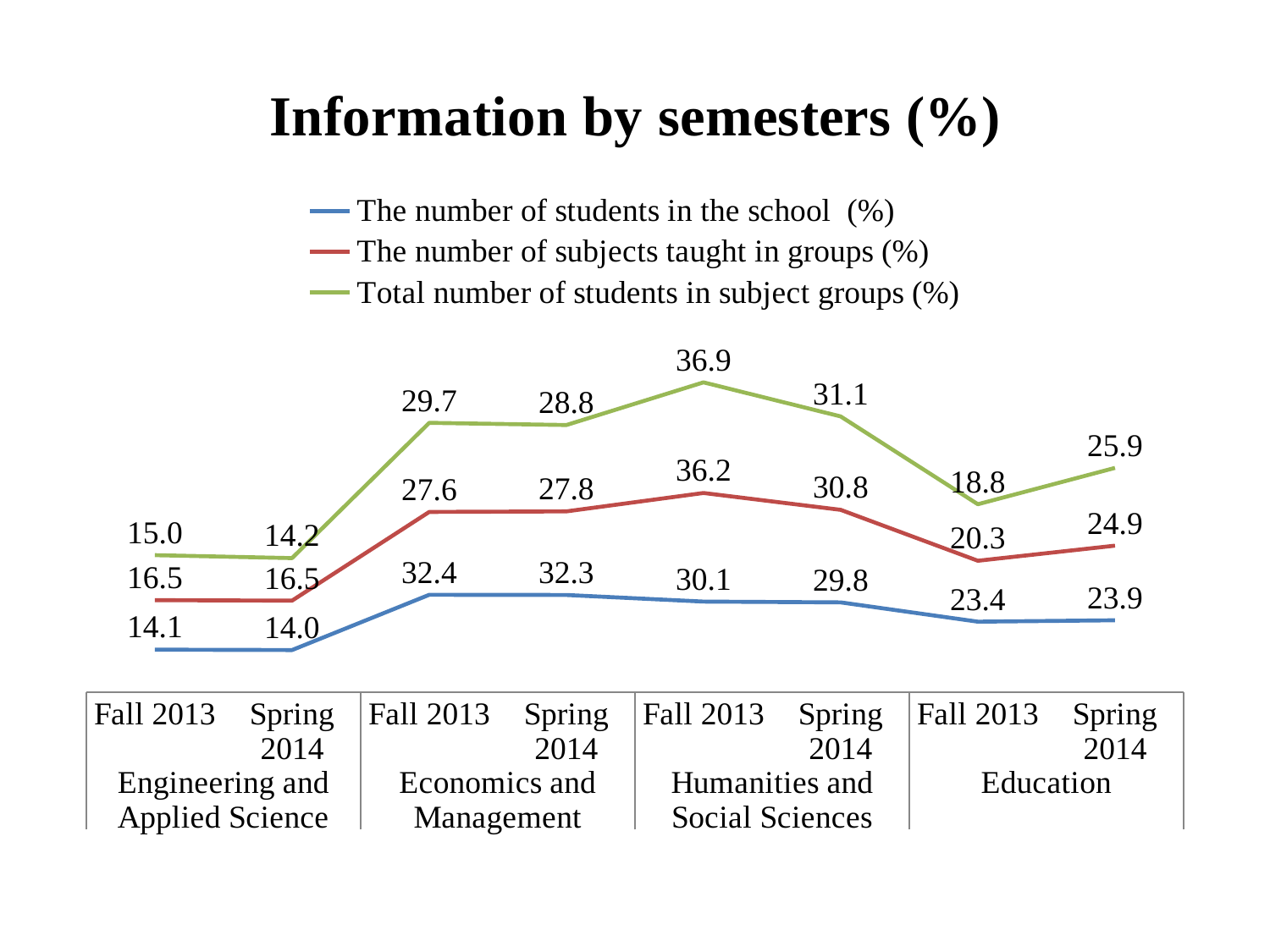
How many series does the legend list? 3 What is the value of 'The number of subjects taught in groups (%)' for Education in Spring 2014? 24.9 What is the value of 'Total number of students in subject groups (%)' for Humanities and Social Sciences in Fall 2013? 36.9 What is the title of the chart? Information by semesters (%) What type of chart is shown on the slide? Line chart What is the difference between the 'Total number of students in subject groups (%)' values for Humanities and Social Sciences in Fall 2013 and Spring 2014? 5.8 At which semester and school is 'The number of students in the school (%)' lowest? Engineering and Applied Science, Spring 2014 How many data points are plotted along the x axis for each series? 8 At which semester and school does 'Total number of students in subject groups (%)' reach its highest value? Humanities and Social Sciences, Fall 2013 For Education in Fall 2013, which is larger: 'The number of students in the school (%)' or 'Total number of students in subject groups (%)'? The number of students in the school (%) What is the value of 'The number of students in the school (%)' for Economics and Management in Fall 2013? 32.4 Does 'Total number of students in subject groups (%)' for Education rise or fall from Fall 2013 to Spring 2014? Rise